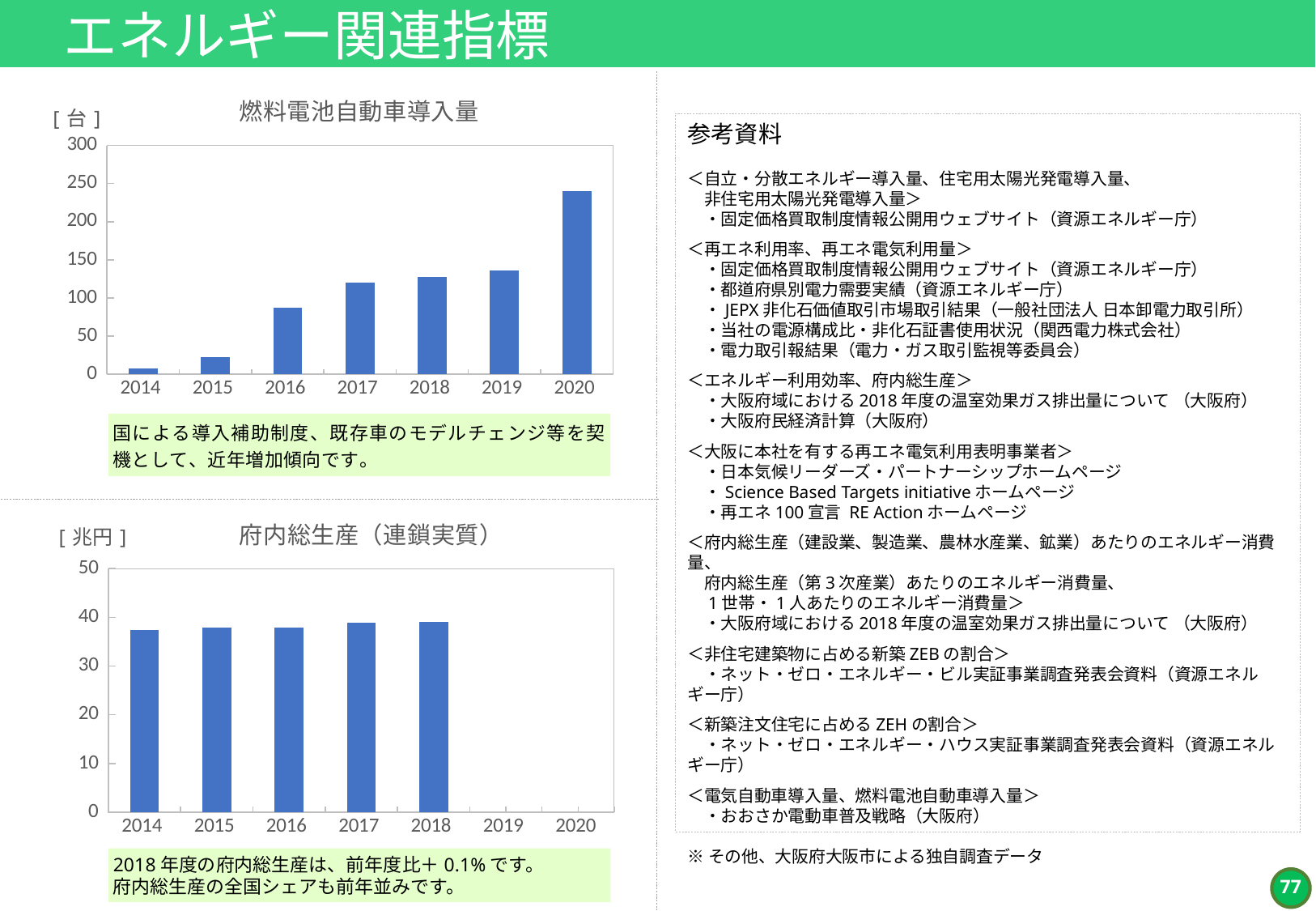
In the 燃料電池自動車導入量 chart, is the value for 2016 greater or less than 100? less In the 府内総生産（連鎖実質） chart, how many years have a bar plotted? 5 How many years are shown on the x axis of the 燃料電池自動車導入量 chart? 7 In the 府内総生産（連鎖実質） chart, is the value for 2018 greater or less than 40? less In the 燃料電池自動車導入量 chart, which year has the lowest value? 2014 In the 燃料電池自動車導入量 chart, do the values generally rise or fall from 2014 to 2020? rise What unit is shown for the 府内総生産（連鎖実質） chart's vertical axis? 兆円 In the 燃料電池自動車導入量 chart, is the value for 2019 greater or less than 100? greater In the 燃料電池自動車導入量 chart, which is larger, the value for 2016 or the value for 2015? 2016 In the 燃料電池自動車導入量 chart, which year has the highest value? 2020 What kind of chart is the 府内総生産（連鎖実質） chart? bar chart